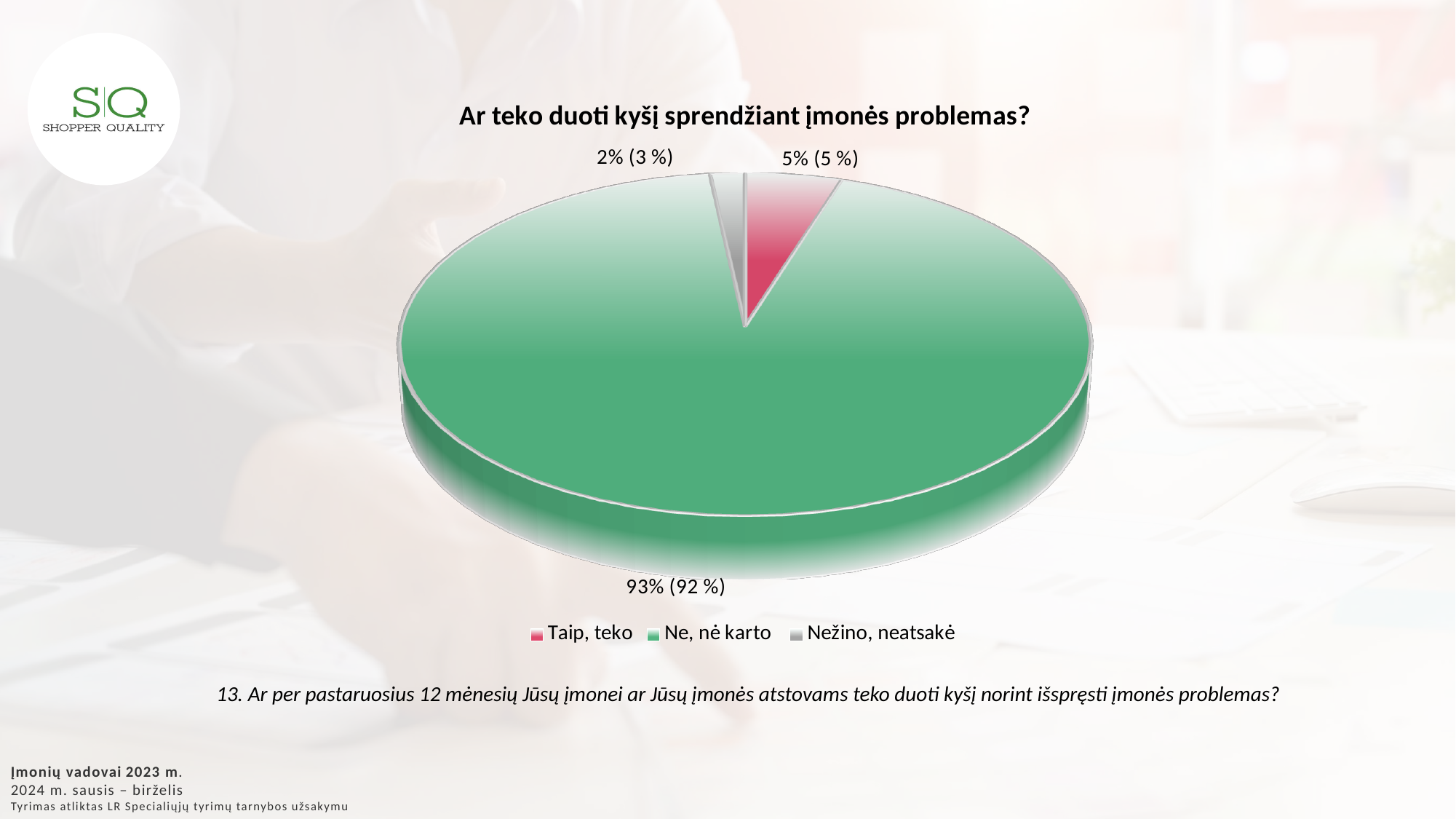
How many entries does the legend list? 3 Which category has the smallest share of the pie? Nežino, neatsakė What data label is shown for the slice "Ne, nė karto"? 93% (92 %) Which category has the largest share of the pie? Ne, nė karto Which slice is larger, "Taip, teko" or "Nežino, neatsakė"? Taip, teko What colour is the slice for "Taip, teko"? red How many slices does the pie chart have? 3 What data label is shown for the slice "Nežino, neatsakė"? 2% (3 %) What kind of chart is shown on the slide? pie chart By how many percentage points does the first figure for "Ne, nė karto" (93%) exceed the first figure for "Taip, teko" (5%)? 88 What is the title of the chart? Ar teko duoti kyšį sprendžiant įmonės problemas? What data label is shown for the slice "Taip, teko"? 5% (5 %)